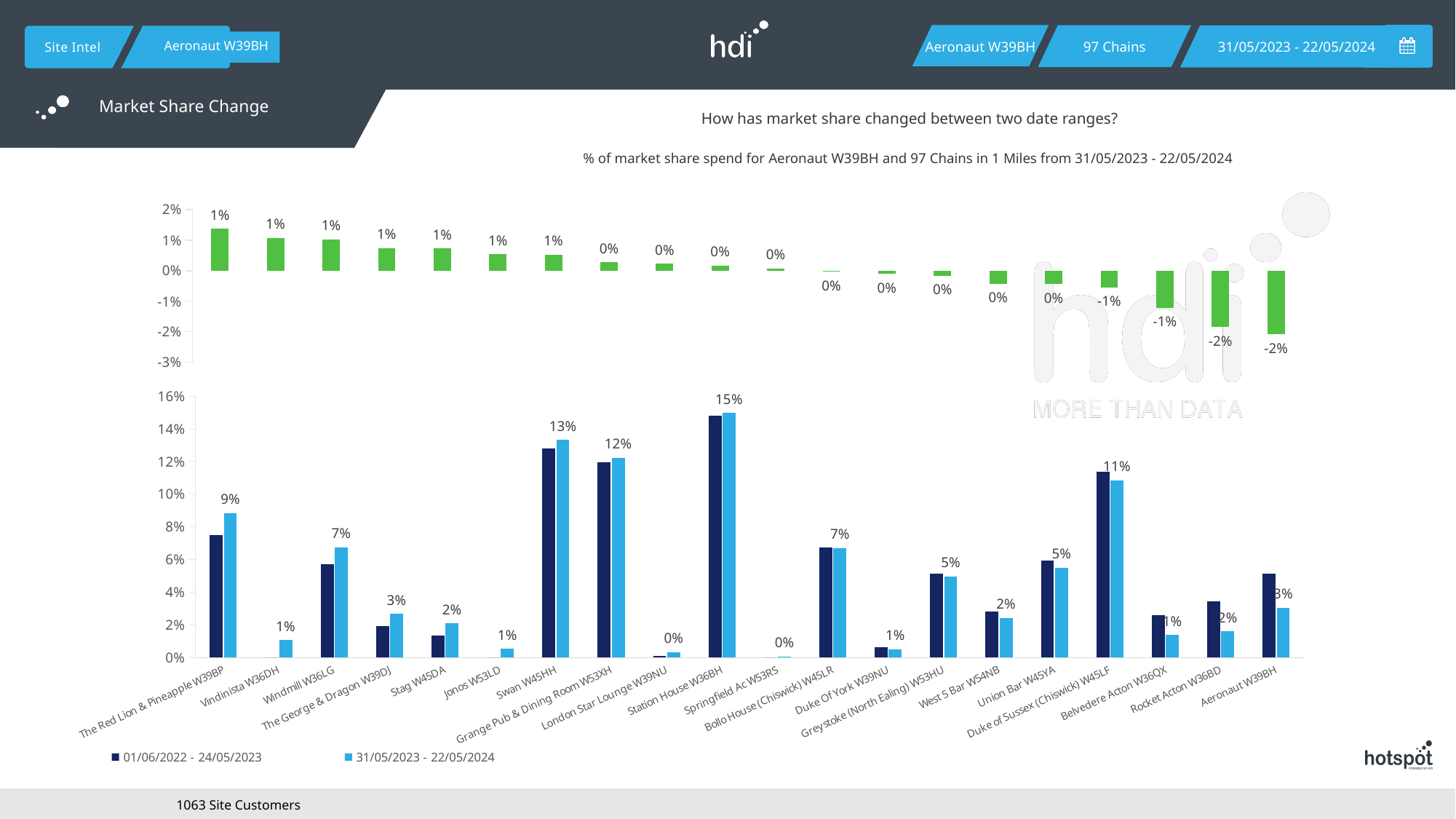
In the lower chart, what is the labelled market share for Aeronaut W39BH? 3% In the lower chart, what is the labelled market share for Swan W45HH? 13% How many series does the legend of the lower chart list? 2 In the lower chart, what is the labelled market share for Station House W36BH? 15% In the lower chart, which has the larger labelled value: Swan W45HH or Grange Pub & Dining Room W53XH? Swan W45HH In the lower chart, which venue has the highest market share? Station House W36BH What are the two legend entries of the lower chart? 01/06/2022 - 24/05/2023 and 31/05/2023 - 22/05/2024 In the lower chart, is the 01/06/2022 - 24/05/2023 value for Duke of Sussex (Chiswick) W45LF greater or less than 10%? greater What kind of chart is the lower chart on the slide? bar chart In the upper chart, what is the lowest data label shown? -2% In the lower chart, what is the difference between the labelled values for Station House W36BH and Swan W45HH? 2% How many venues are shown along the x axis of the lower chart? 20